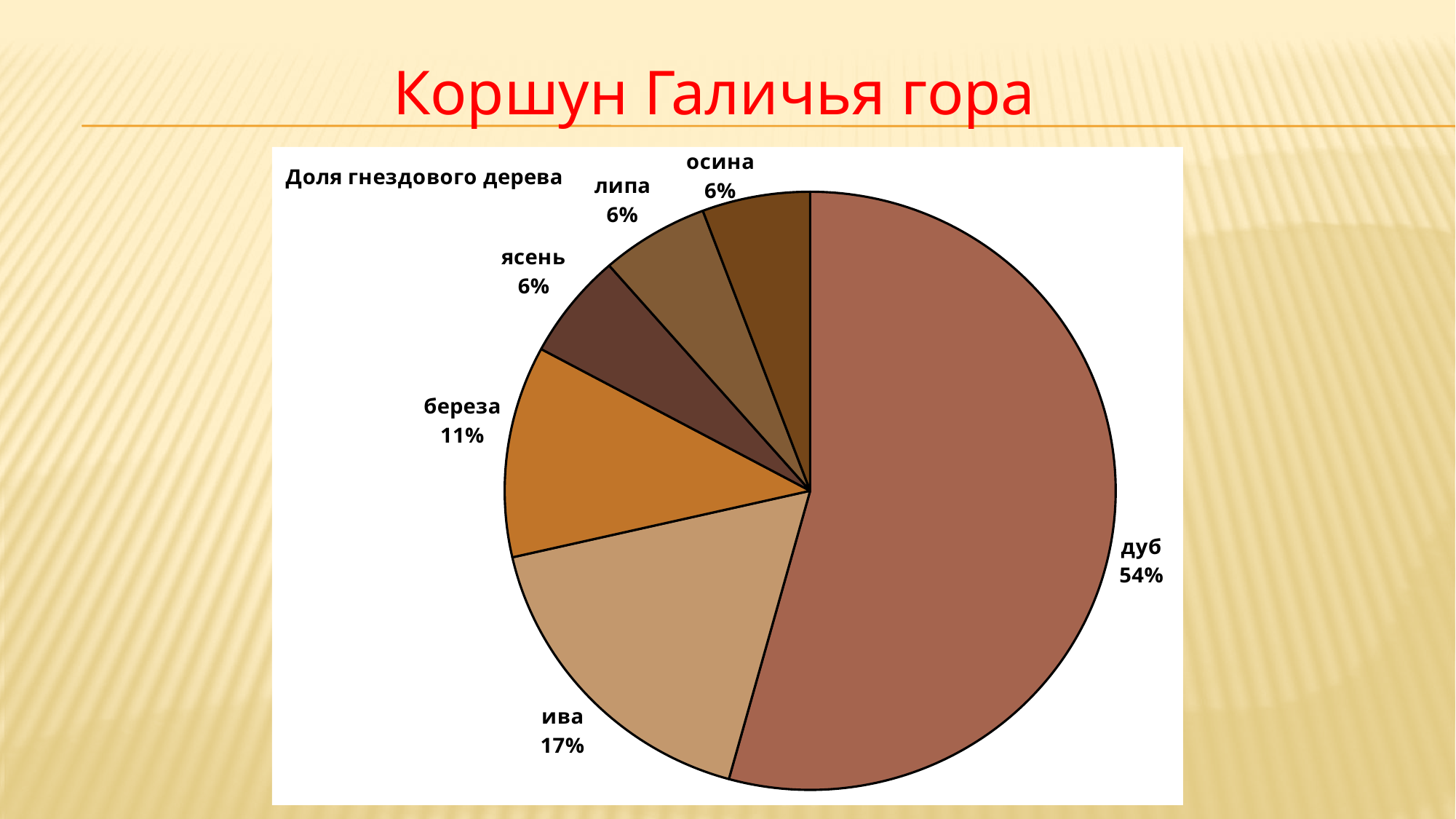
What is the difference between the shares of ива and береза? 6% What share of the pie does ясень have? 6% What share of the pie does береза have? 11% Which has a larger share, береза or липа? береза What share of the pie does ива have? 17% What is the title of the chart? Доля гнездового дерева How many tree categories are shown in the pie chart? 6 Which tree has the largest share of the pie? дуб What is the difference between the shares of дуб and ива? 37% How many tree categories have a share of 6%? 3 What kind of chart is shown on the slide? pie chart